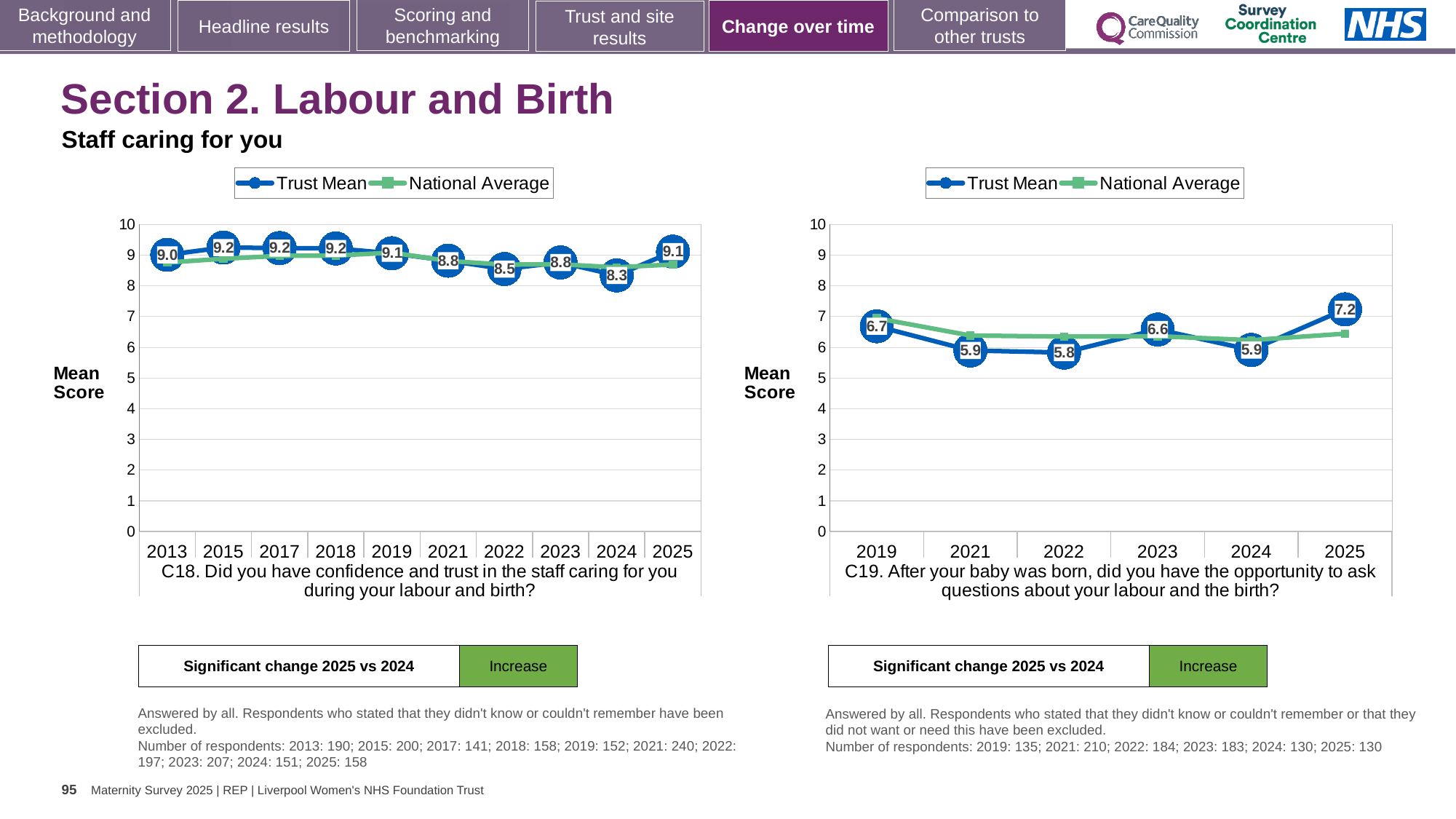
In the C18 chart (left), which year has the lowest Trust Mean? 2024 In the C18 chart (left), what is the difference between the Trust Mean in 2025 and in 2024? 0.8 What kind of chart is the C18 chart (left)? Line chart In the C18 chart (left), how many years are plotted on the x axis? 10 How many series does the legend of the C19 chart (right) list? 2 In the C18 chart (left), what is the Trust Mean for 2025? 9.1 In the C19 chart (right), which year has the highest Trust Mean? 2025 In the C19 chart (right), which year has the lowest Trust Mean? 2022 In the C19 chart (right), is the National Average for 2025 greater or less than 7? less In the C18 chart (left), what is the Trust Mean for 2024? 8.3 In the C19 chart (right), is the Trust Mean for 2023 larger or smaller than the Trust Mean for 2021? larger In the C19 chart (right), what is the Trust Mean for 2025? 7.2